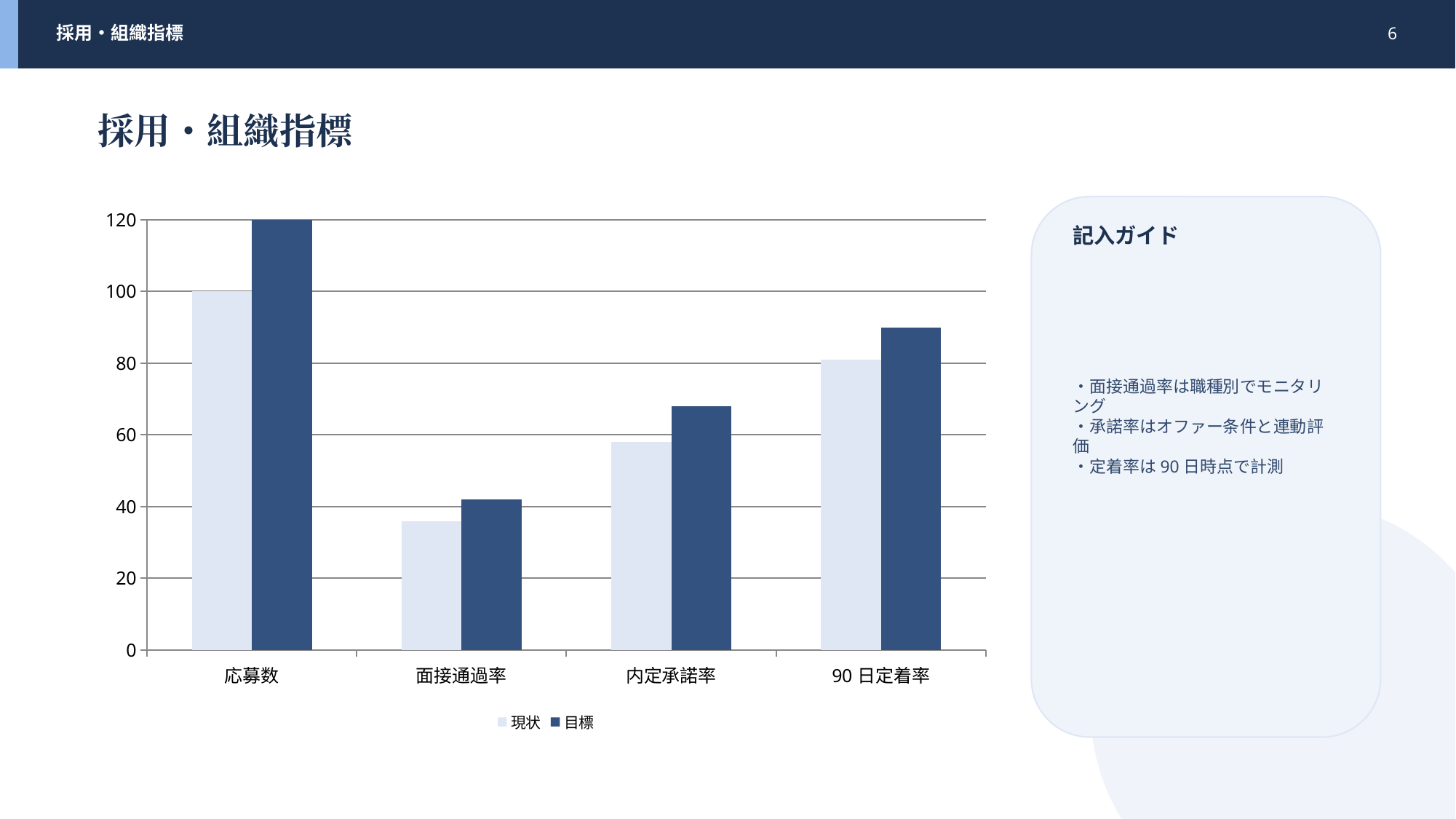
How many series does the chart legend list? 2 What type of chart is shown on the slide? bar chart Which category has the lowest 現状 value? 面接通過率 Which category has the highest 目標 value? 応募数 What are the two series names listed in the chart legend? 現状 and 目標 For 90 日定着率, which is larger, the 現状 value or the 目標 value? 目標 Is the 現状 value for 面接通過率 greater or less than 40? less Is the 目標 value for 内定承諾率 greater or less than 60? greater How many categories are shown on the x axis of the chart? 4 What is the 現状 value for 応募数? 100